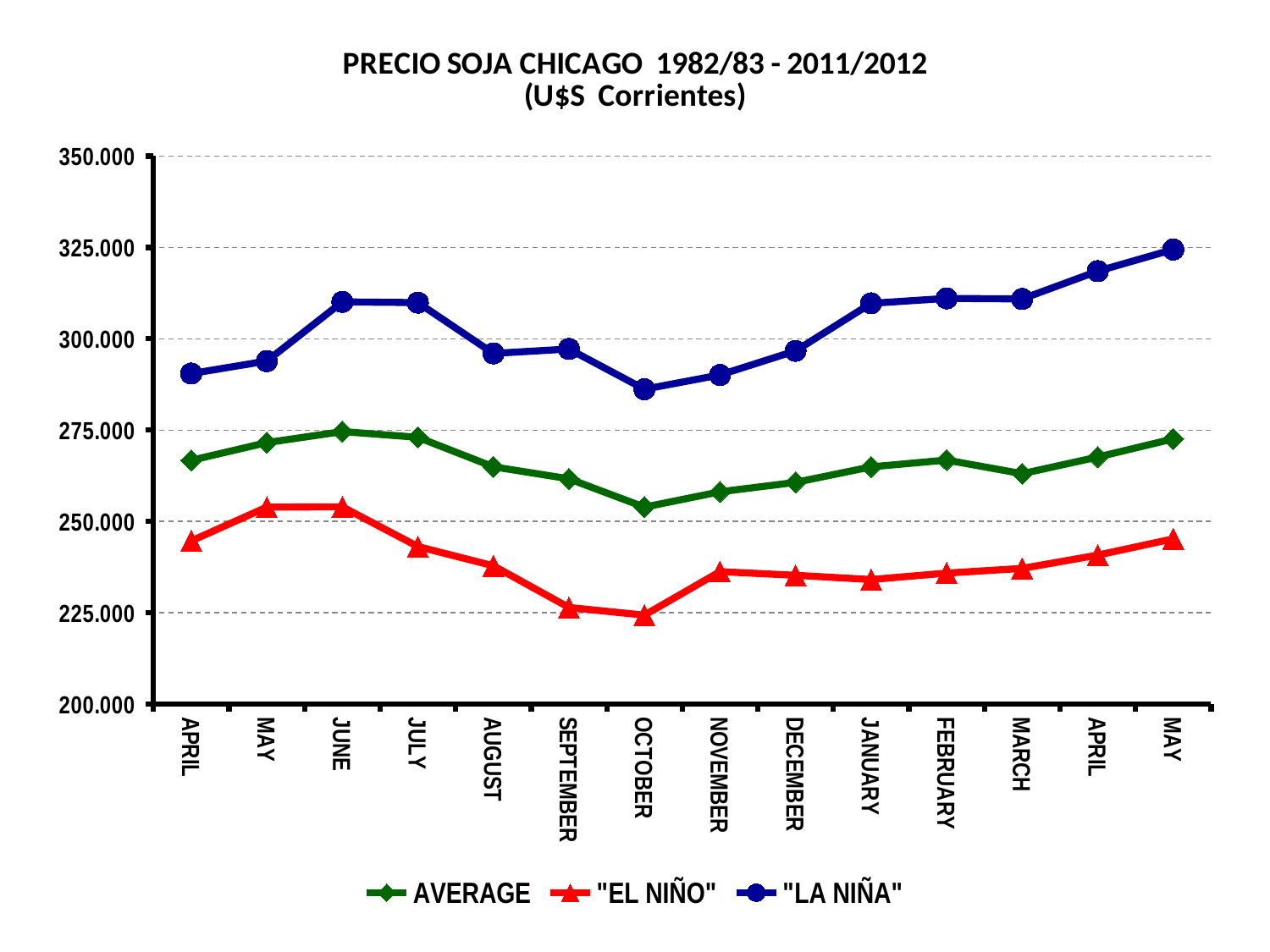
Which series has the higher value in DECEMBER, "EL NIÑO" or "LA NIÑA"? "LA NIÑA" Does the "LA NIÑA" series rise or fall from OCTOBER to the final MAY? rise In which month does the "EL NIÑO" series reach its lowest value? OCTOBER Is the "LA NIÑA" value for JUNE greater or less than 300.000? greater What kind of chart is shown on the slide? line chart In which month does the "LA NIÑA" series reach its lowest value? OCTOBER Is the "EL NIÑO" value for the first APRIL greater or less than 250.000? less In which month does the AVERAGE series reach its lowest value? OCTOBER How many series does the legend list? 3 How many months are plotted along the x axis? 14 In which month does the "LA NIÑA" series reach its highest value? MAY (the last month) Is the "LA NIÑA" value for OCTOBER greater or less than 300.000? less